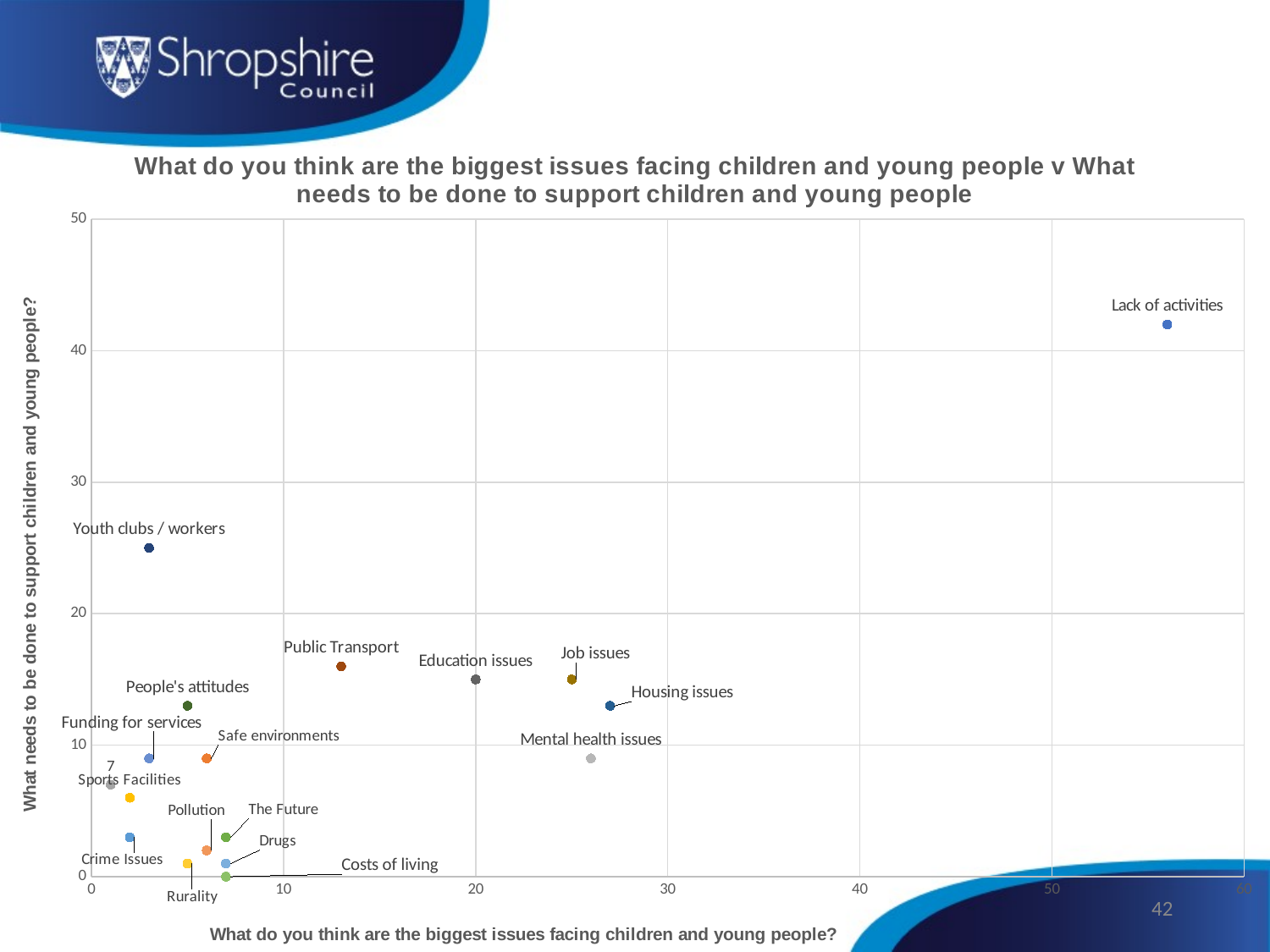
Is the vertical-axis value for Public Transport greater or less than 10? greater Is the vertical-axis value for Youth clubs / workers greater or less than 20? greater Which has the higher vertical-axis value, Youth clubs / workers or Public Transport? Youth clubs / workers Which issue has the highest value on the horizontal axis (biggest issues facing children and young people)? Lack of activities Is the horizontal-axis value for Housing issues greater or less than 20? greater Which has the larger horizontal-axis value, Housing issues or Education issues? Housing issues Which issue has the highest value on the vertical axis (what needs to be done to support children and young people)? Lack of activities What is the label of the vertical axis? What needs to be done to support children and young people? What is the label of the horizontal axis? What do you think are the biggest issues facing children and young people? What kind of chart is shown on the slide? scatter chart